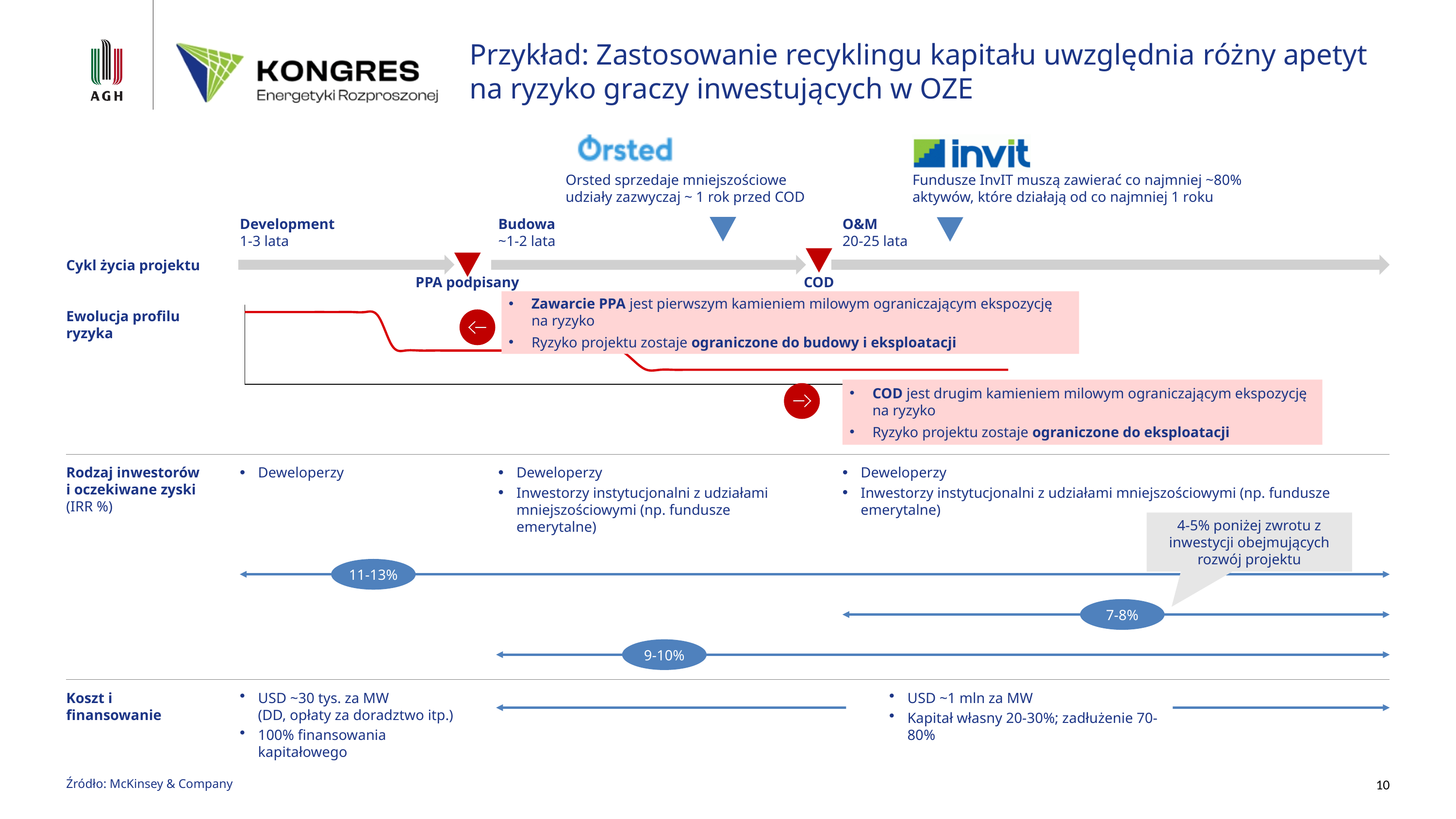
What expected IRR is shown on the arrow that starts at the Budowa phase? 9-10% What kind of chart is used to show 'Ewolucja profilu ryzyka'? line chart Which phase's arrow shows the lowest expected IRR range? O&M (7-8%) In the 'Ewolucja profilu ryzyka' diagram, at which milestone does the red line drop for the second time? COD How many IRR range labels are shown on the arrows in the 'Rodzaj inwestorów i oczekiwane zyski' section? 3 In the 'Ewolucja profilu ryzyka' diagram, at which milestone does the red line first drop? PPA podpisany Which is higher: the IRR range for investors entering at Budowa or at O&M? Budowa (9-10%) What expected IRR is shown on the arrow that starts at the Development phase? 11-13% What expected IRR is shown on the arrow that starts at the O&M phase? 7-8% How many project phases are shown on the 'Cykl życia projektu' timeline? 3 In the 'Ewolucja profilu ryzyka' diagram, does the red risk line rise or fall as the project moves from Development to O&M? fall Which phase's arrow shows the highest expected IRR range? Development (11-13%)